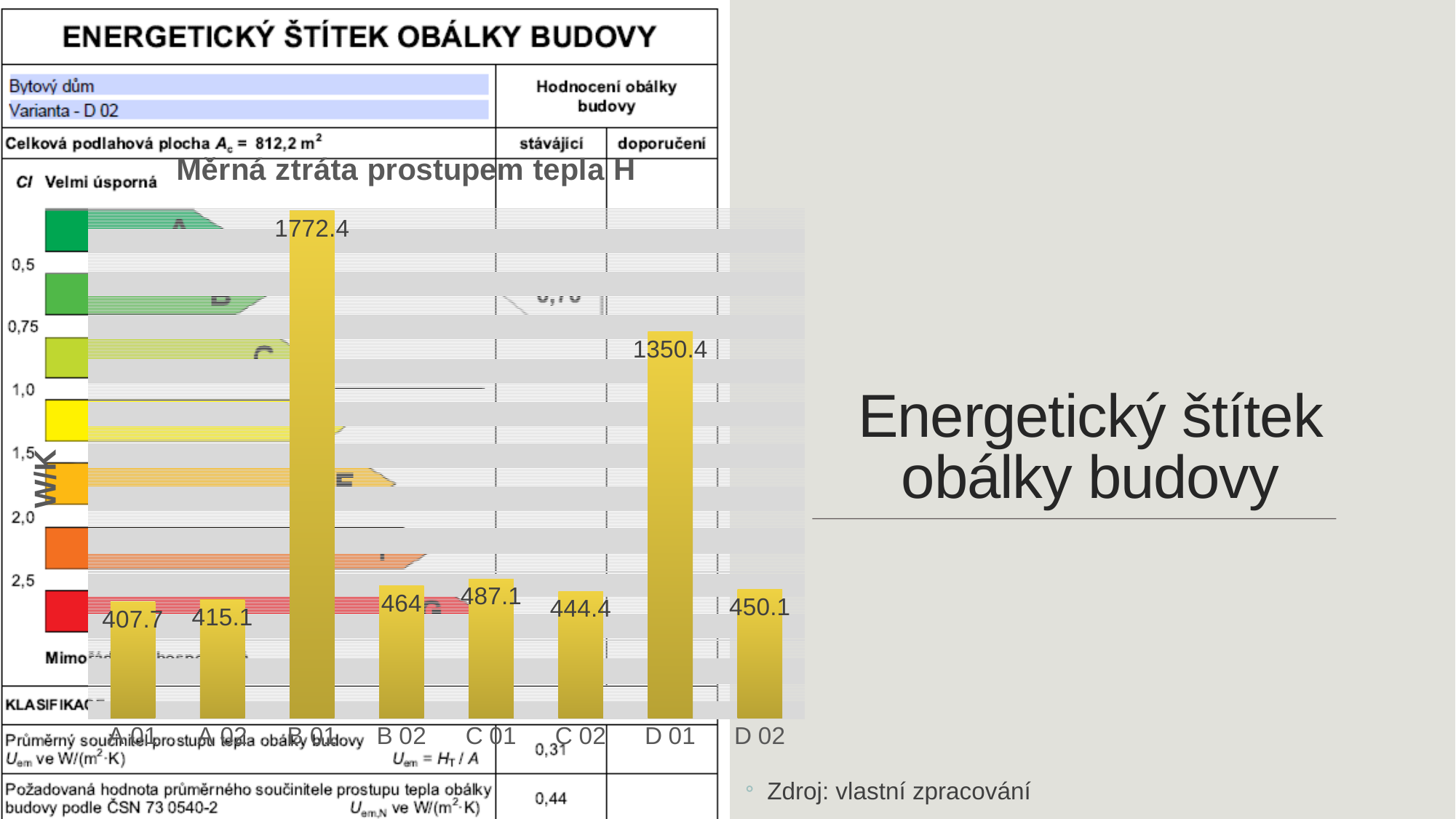
What is the difference between the values for B 01 and D 01? 422 What unit is shown on the vertical axis label of the bar chart? W/K What is the value for B 01 in the bar chart? 1772.4 What is the title of the bar chart? Měrná ztráta prostupem tepla H How many categories are shown in the bar chart? 8 Which category has the highest value in the bar chart? B 01 What type of chart is used to show Měrná ztráta prostupem tepla H? bar chart What is the value for A 01 in the bar chart? 407.7 What is the value for D 01 in the bar chart? 1350.4 Which has a larger value, C 01 or B 02? C 01 What is the value for C 02 in the bar chart? 444.4 Which category has the lowest value in the bar chart? A 01